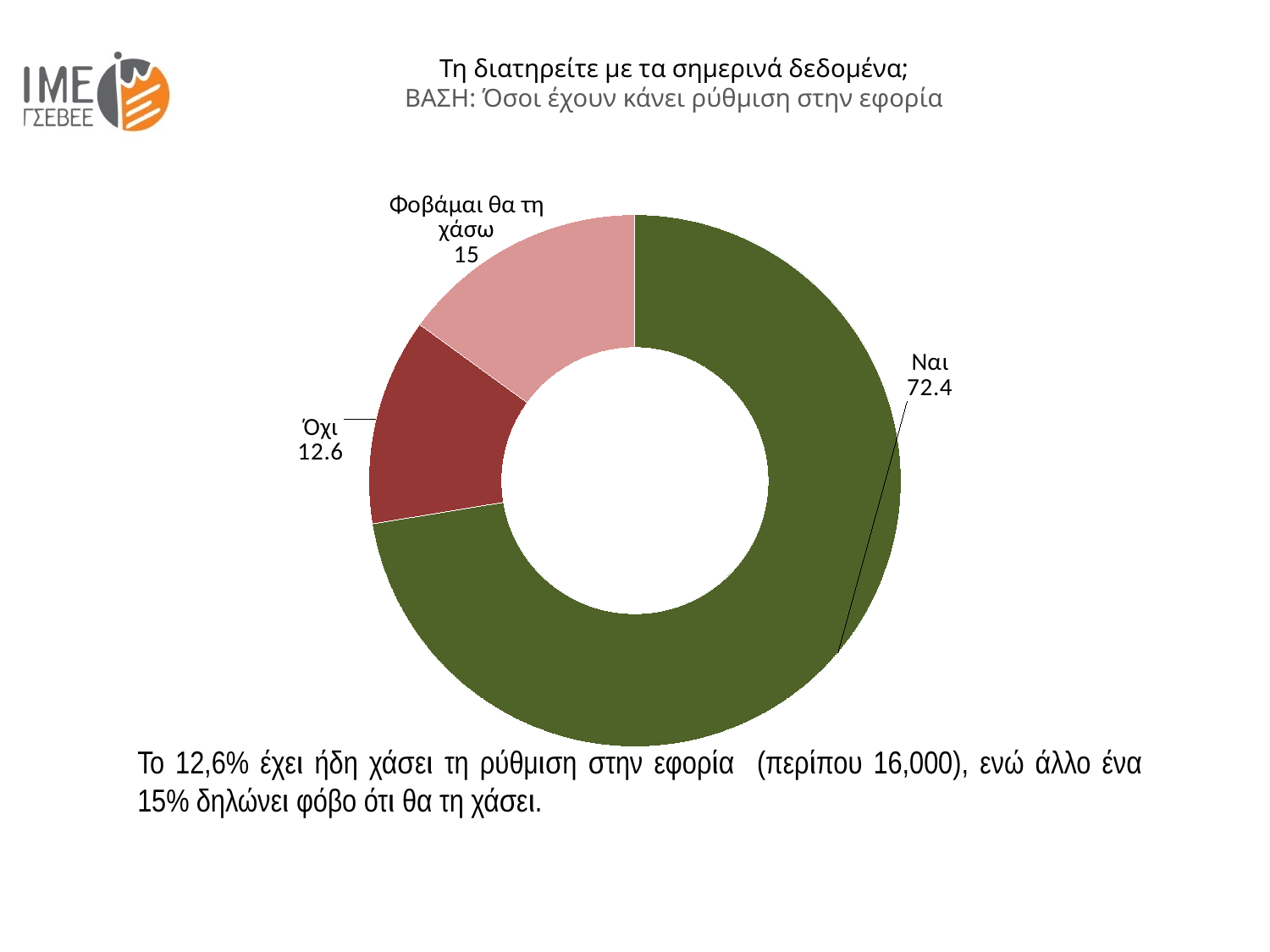
What is the difference between the values for "Ναι" and "Όχι"? 59.8 How many categories are shown in the chart? 3 What is the difference between the values for "Φοβάμαι θα τη χάσω" and "Όχι"? 2.4 Which category has the smallest slice? Όχι What colour is the "Ναι" slice? Dark green Which category has the largest slice? Ναι What is the value for the "Φοβάμαι θα τη χάσω" slice? 15 What is the value for the "Ναι" slice? 72.4 What is the value for the "Όχι" slice? 12.6 What type of chart is shown on the slide? Doughnut (pie) chart What is the title of the chart? Τη διατηρείτε με τα σημερινά δεδομένα; ΒΑΣΗ: Όσοι έχουν κάνει ρύθμιση στην εφορία Which is larger, the value for "Όχι" or the value for "Φοβάμαι θα τη χάσω"? Φοβάμαι θα τη χάσω